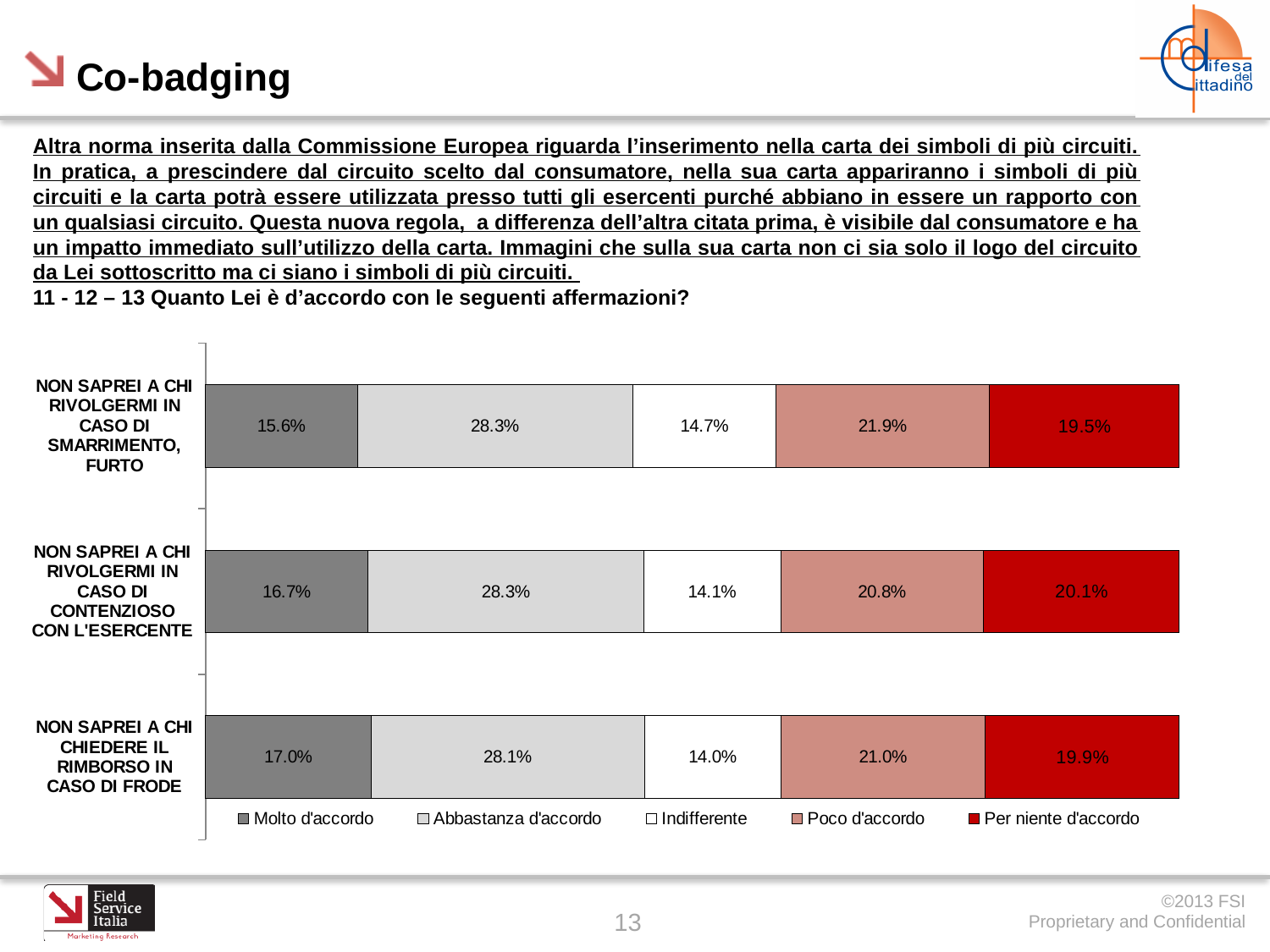
Which category has the lowest value for "Indifferente"? NON SAPREI A CHI CHIEDERE IL RIMBORSO IN CASO DI FRODE What is the value for "Indifferente" in the category "NON SAPREI A CHI CHIEDERE IL RIMBORSO IN CASO DI FRODE"? 14.0% Which category has the highest value for "Molto d'accordo"? NON SAPREI A CHI CHIEDERE IL RIMBORSO IN CASO DI FRODE How many categories (statements) are shown in the chart? 3 What is the value for "Molto d'accordo" in the category "NON SAPREI A CHI RIVOLGERMI IN CASO DI SMARRIMENTO, FURTO"? 15.6% What is the difference between the "Molto d'accordo" values for "NON SAPREI A CHI CHIEDERE IL RIMBORSO IN CASO DI FRODE" and "NON SAPREI A CHI RIVOLGERMI IN CASO DI SMARRIMENTO, FURTO"? 1.4 percentage points What is the value for "Abbastanza d'accordo" in the category "NON SAPREI A CHI RIVOLGERMI IN CASO DI CONTENZIOSO CON L'ESERCENTE"? 28.3% How many series does the legend list? 5 What is the value for "Per niente d'accordo" in the category "NON SAPREI A CHI RIVOLGERMI IN CASO DI CONTENZIOSO CON L'ESERCENTE"? 20.1% What kind of chart is shown on the slide? Stacked bar chart What is the total of the stacked bar for "NON SAPREI A CHI RIVOLGERMI IN CASO DI SMARRIMENTO, FURTO"? 100.0% Which is larger: the "Poco d'accordo" value for "NON SAPREI A CHI RIVOLGERMI IN CASO DI SMARRIMENTO, FURTO" or for "NON SAPREI A CHI RIVOLGERMI IN CASO DI CONTENZIOSO CON L'ESERCENTE"? NON SAPREI A CHI RIVOLGERMI IN CASO DI SMARRIMENTO, FURTO